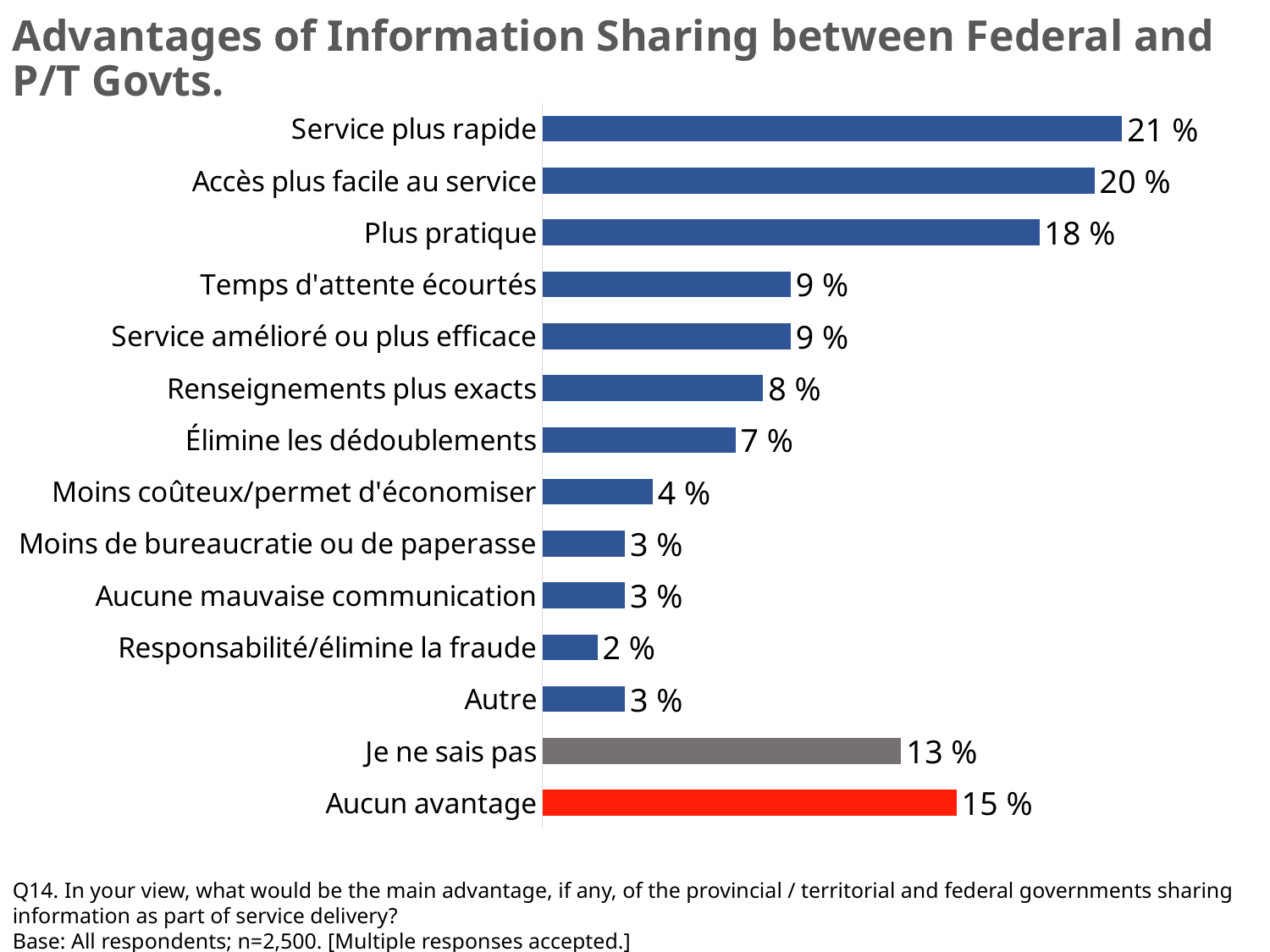
What is the value for "Je ne sais pas"? 13 % What is the value for "Élimine les dédoublements"? 7 % What colour is the bar for "Aucun avantage"? Red What is the value for "Aucun avantage"? 15 % Which is larger, "Accès plus facile au service" or "Aucun avantage"? Accès plus facile au service What is the difference between "Service plus rapide" and "Plus pratique"? 3 % What is the value for "Service plus rapide"? 21 % Which category has the lowest value? Responsabilité/élimine la fraude Which category has the highest value? Service plus rapide What kind of chart is shown on the slide? Bar chart What is the difference between "Aucun avantage" and "Je ne sais pas"? 2 % How many categories are shown in the chart? 14